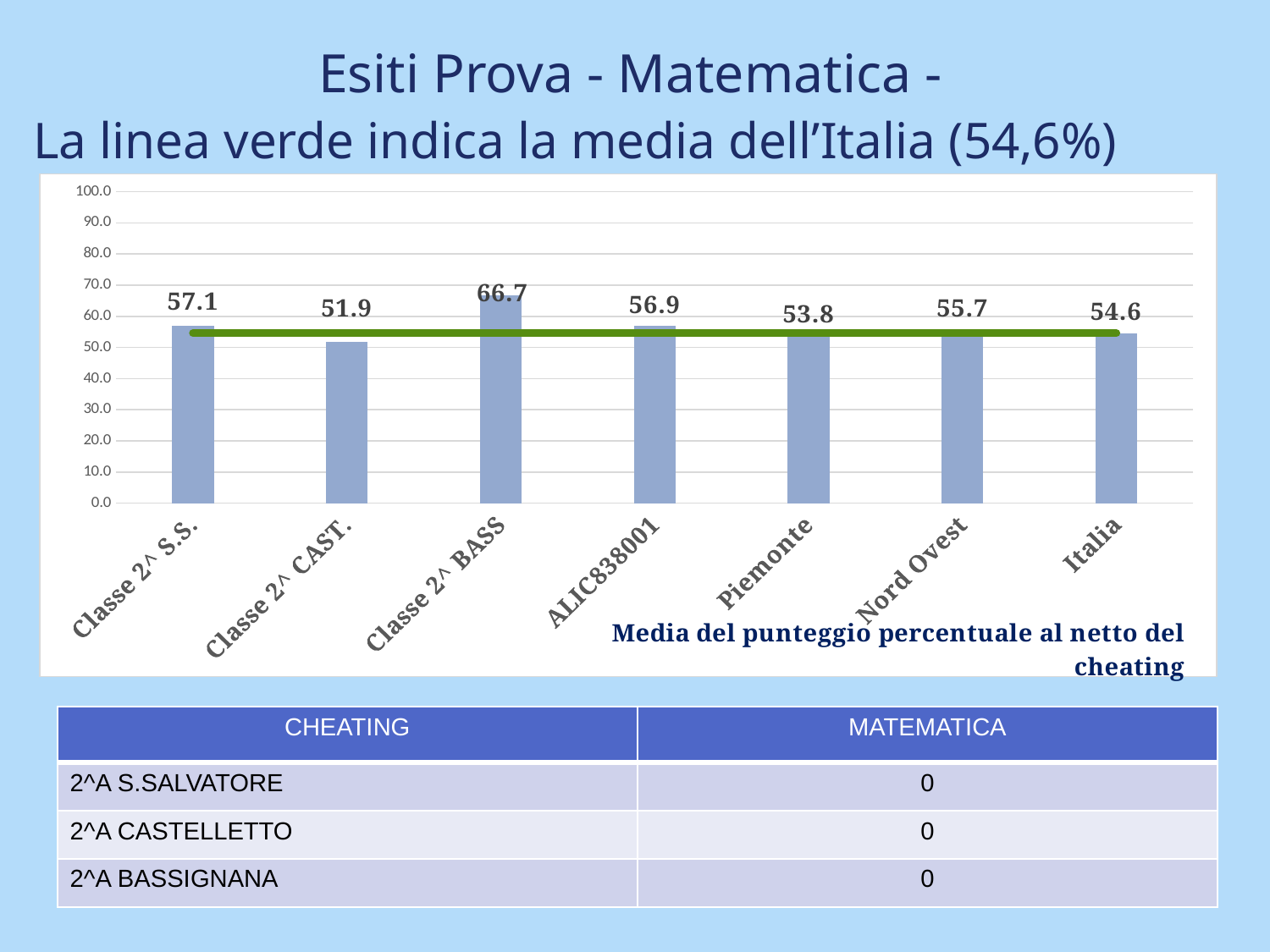
What is the difference between the values for Classe 2^ BASS and Classe 2^ CAST.? 14.8 What does the green line on the chart indicate? la media dell'Italia (54,6%) Is the value for Classe 2^ CAST. greater or less than 60.0? less What is the difference between the values for Classe 2^ S.S. and Italia? 2.5 What kind of chart is shown on the slide? bar chart How many categories are shown on the x axis? 7 Which category has the highest value? Classe 2^ BASS What is the value for Classe 2^ BASS? 66.7 Which category has the lowest value? Classe 2^ CAST. What is the value for Piemonte? 53.8 Which is larger, the value for Nord Ovest or the value for Piemonte? Nord Ovest What is the value for ALIC838001? 56.9